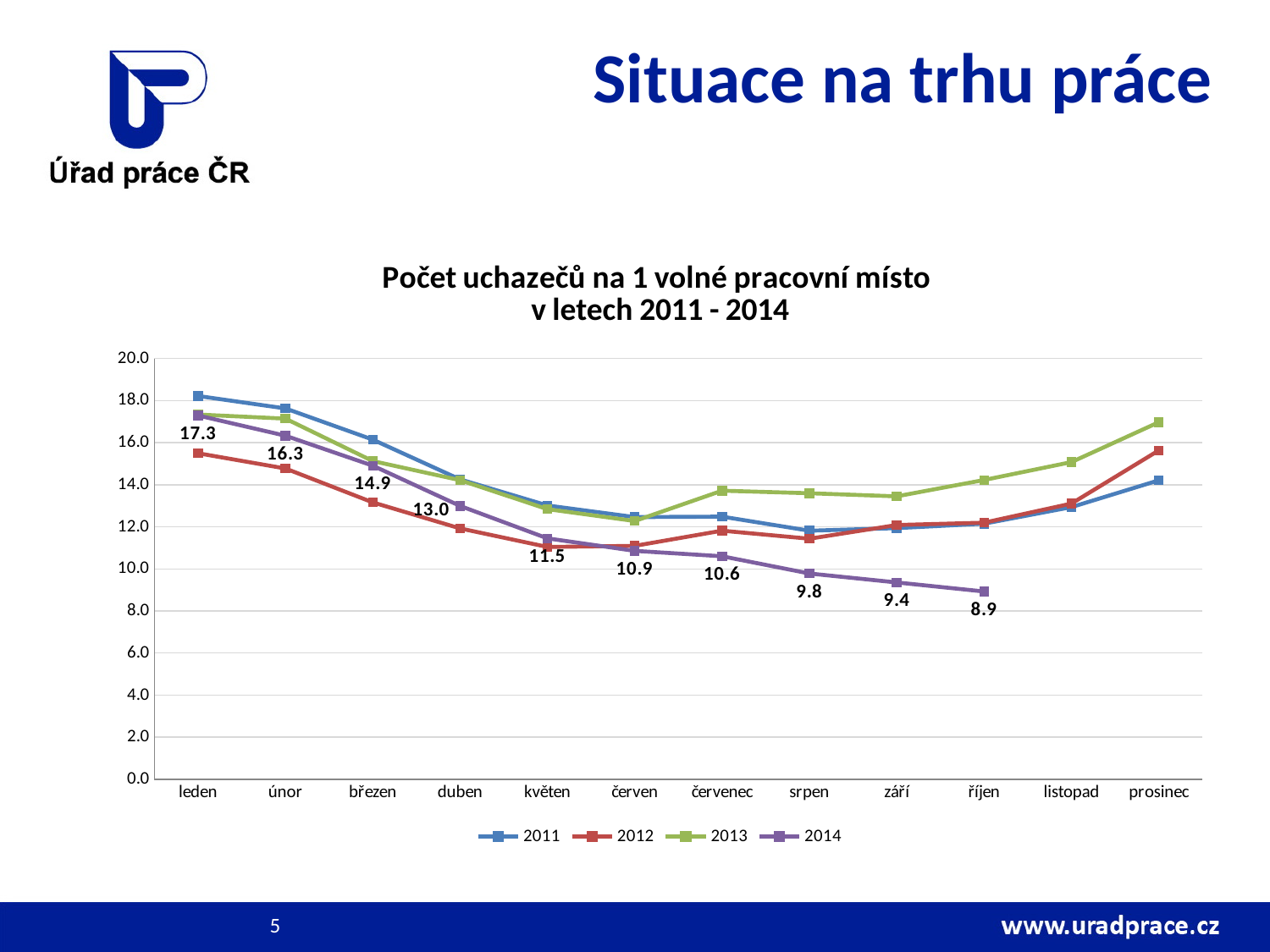
What is the value for 2014 in říjen? 8.9 What type of chart is shown on the slide? line chart Which series is shown in green in the legend? 2013 In which month is the 2014 value the lowest? říjen What is the value for 2014 in leden? 17.3 Is the value for 2013 in prosinec greater or less than 16.0? greater What is the difference between the 2014 values for leden and říjen? 8.4 How many series does the legend list? 4 What is the value for 2014 in červenec? 10.6 How many months are shown on the x axis? 12 Does the 2014 series rise or fall from leden to říjen? fall In which month is the 2014 value the highest? leden